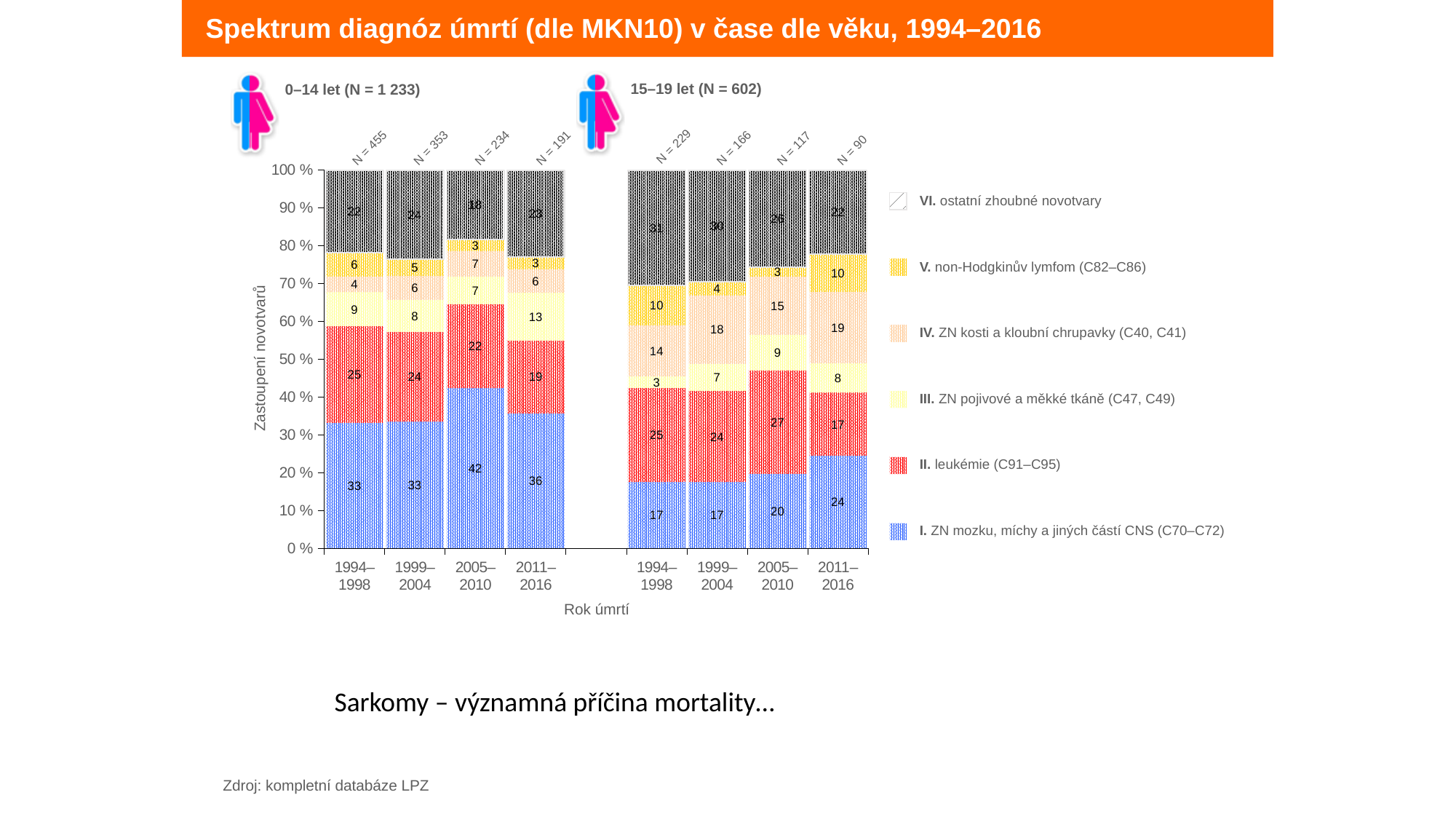
What kind of chart is used on this slide? Stacked bar chart In the 15–19 let chart, does the value for I. ZN mozku, míchy a jiných částí CNS rise or fall from 1999–2004 to 2011–2016? Rise In the 15–19 let chart, in which period is the value for II. leukémie lowest? 2011–2016 How many periods are shown on the x axis of the 15–19 let chart? 4 How many series does the legend list? 6 What is the N printed above the 2011–2016 bar in the 15–19 let chart? N = 90 In the 0–14 let chart, what is the difference between the II. leukémie values for 1994–1998 and 2011–2016? 6 In the 0–14 let chart, what is the value for I. ZN mozku, míchy a jiných částí CNS in 2005–2010? 42 In the 15–19 let chart, what is the value for IV. ZN kosti a kloubní chrupavky in 2011–2016? 19 In the 15–19 let chart, what is the value for VI. ostatní zhoubné novotvary in 1994–1998? 31 In the 0–14 let chart, in which period is the value for I. ZN mozku, míchy a jiných částí CNS highest? 2005–2010 In the 15–19 let chart, which is larger in 1999–2004: the value for II. leukémie or the value for IV. ZN kosti a kloubní chrupavky? II. leukémie